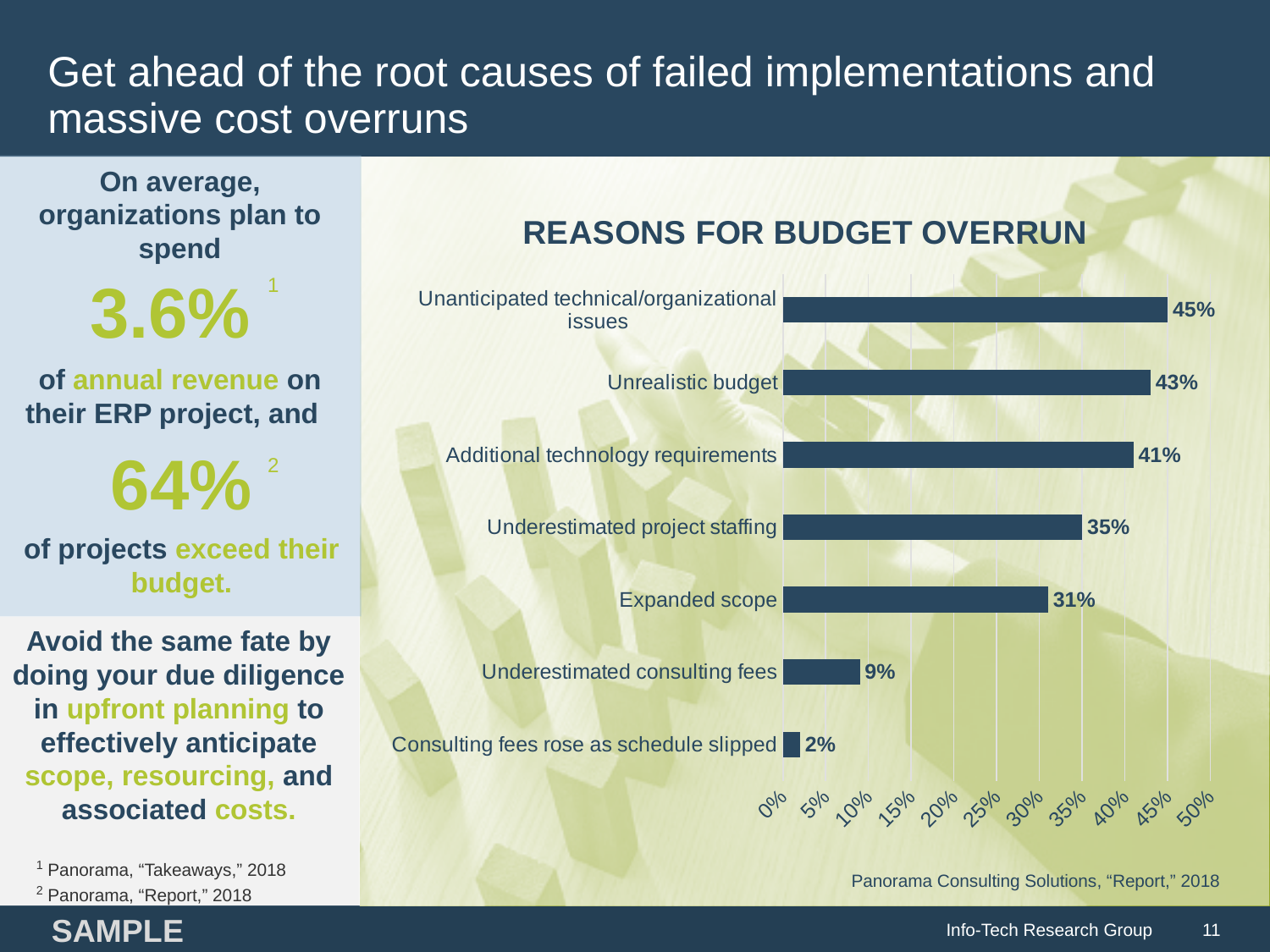
Which is larger, the value for Underestimated consulting fees or the value for Expanded scope? Expanded scope Which reason for budget overrun has the highest value? Unanticipated technical/organizational issues How many reasons for budget overrun are shown in the chart? 7 What is the title of the chart? REASONS FOR BUDGET OVERRUN What is the highest value shown on the chart's x axis? 50% What is the difference between the values for Additional technology requirements and Expanded scope? 10% Is the value for Underestimated project staffing greater or less than 30%? greater What is the value for Consulting fees rose as schedule slipped? 2% What is the value for Unrealistic budget? 43% Which reason for budget overrun has the lowest value? Consulting fees rose as schedule slipped What is the value for Underestimated project staffing? 35% What kind of chart is shown on the slide? Bar chart